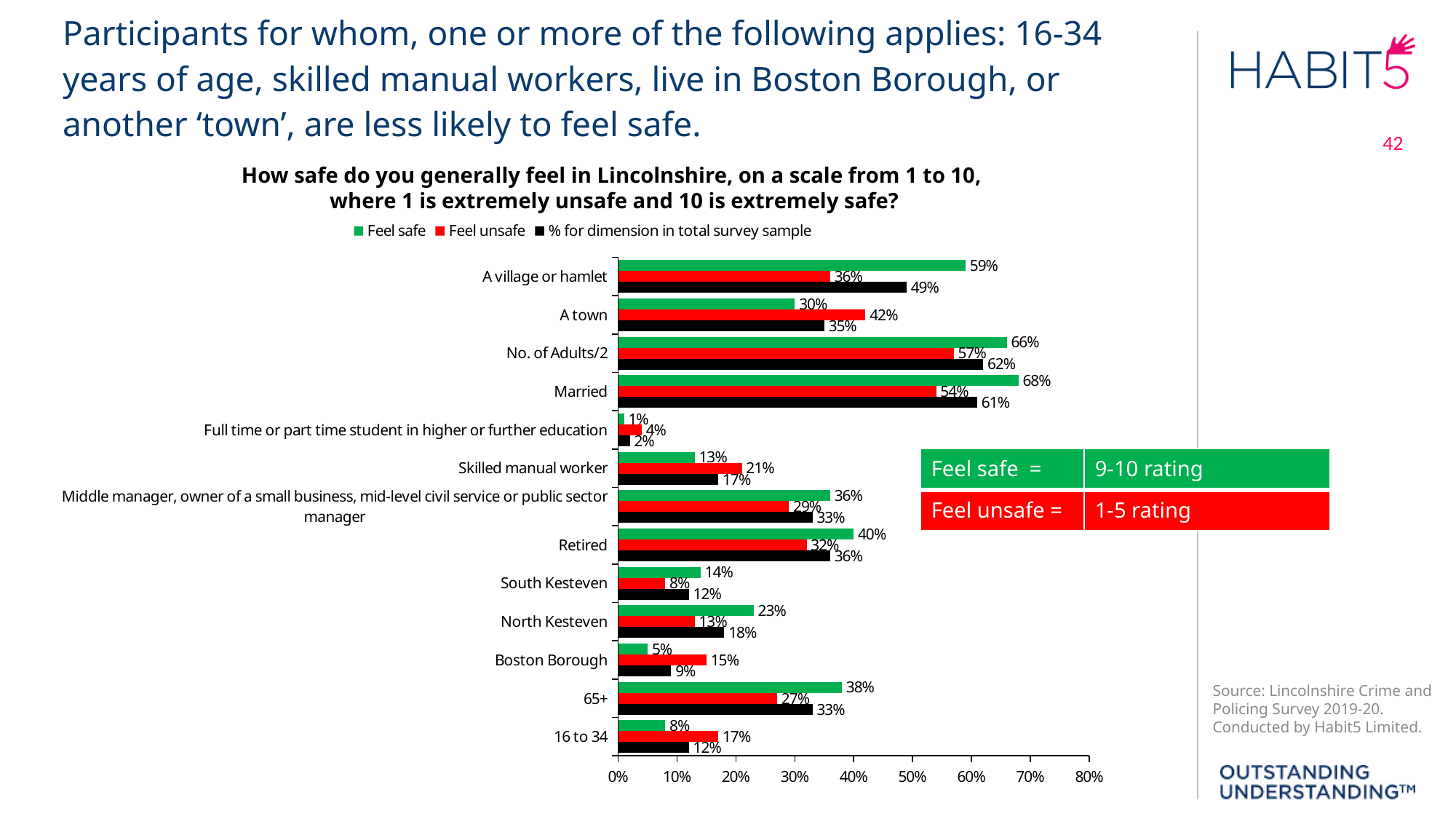
Which category has the highest Feel safe value? Married According to the slide, what rating range counts as 'Feel unsafe'? 1-5 rating How many categories are shown on the chart? 13 How many series does the legend list? 3 What is the Feel safe value for Married? 68% What is the difference between the Feel unsafe and Feel safe values for 16 to 34? 9% What is the '% for dimension in total survey sample' value for Boston Borough? 9% Which category has the highest Feel unsafe value? No. of Adults/2 Which is larger for Skilled manual worker: the Feel safe value or the Feel unsafe value? Feel unsafe What is the Feel unsafe value for A town? 42% What kind of chart is shown on the slide? Bar chart Which category has the lowest Feel safe value? Full time or part time student in higher or further education